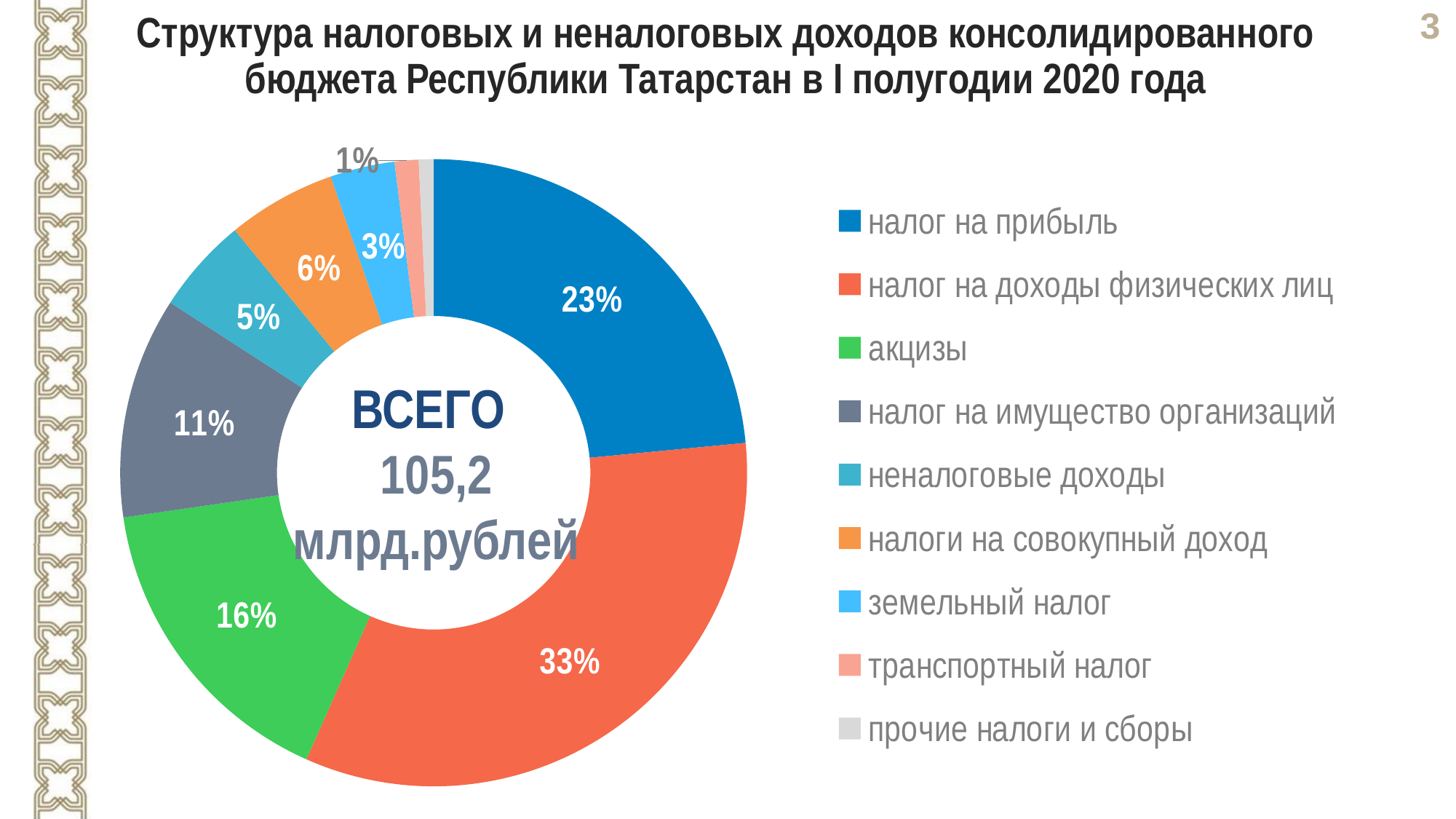
What share of the total does налог на прибыль account for? 23% What share of the total does земельный налог account for? 3% What kind of chart is shown on the slide? doughnut chart What total value is shown in the centre of the chart? 105,2 млрд.рублей What share of the total does налог на доходы физических лиц account for? 33% How many categories does the legend list? 9 What share of the total does налог на имущество организаций account for? 11% Which is larger: the share of акцизы or the share of налог на имущество организаций? акцизы What share of the total do налоги на совокупный доход account for? 6% What share of the total do акцизы account for? 16% What is the difference in percentage points between the share of налог на доходы физических лиц and the share of налог на прибыль? 10% Which category has the largest share of the pie? налог на доходы физических лиц